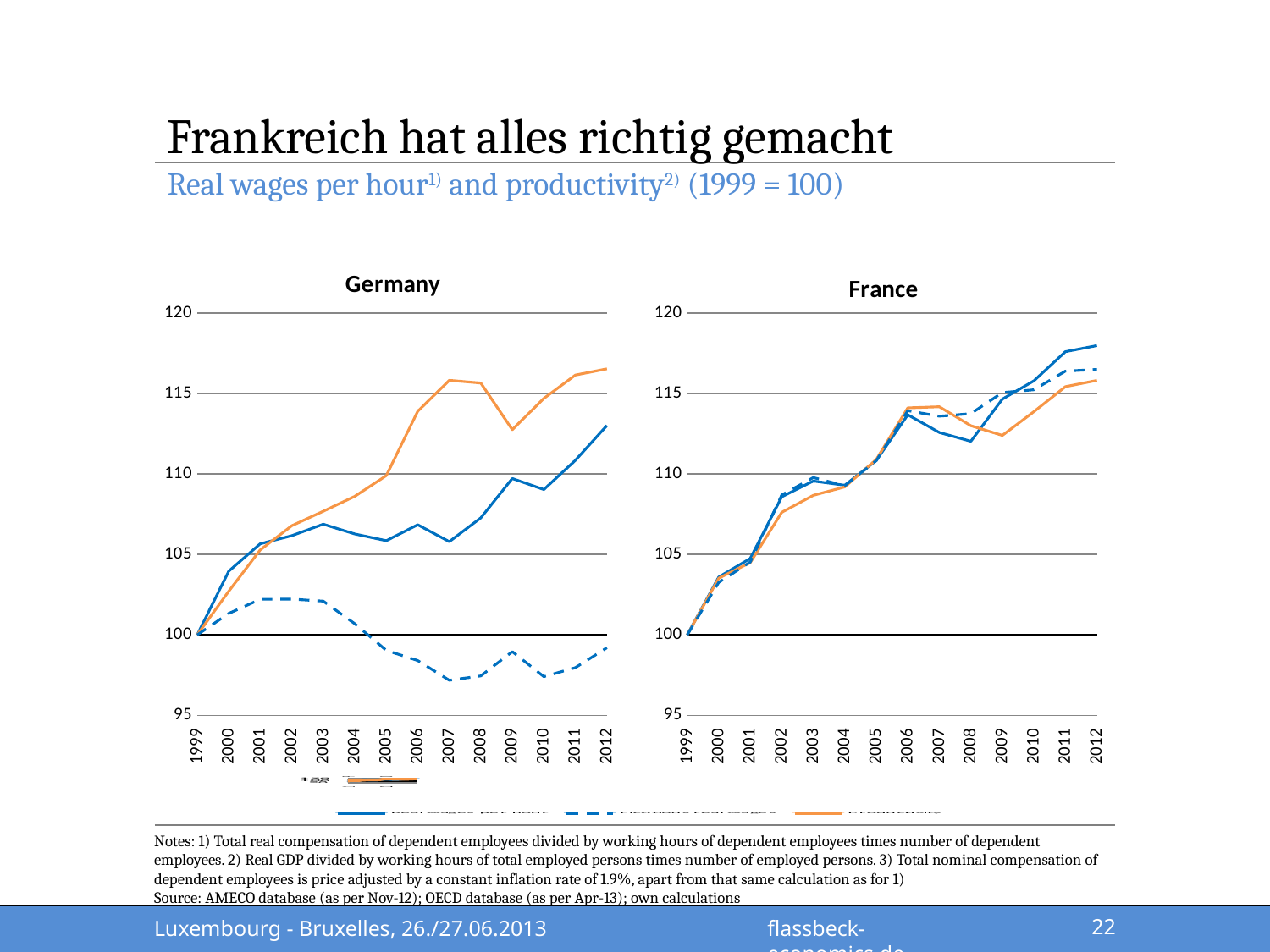
In the Germany chart, is the value of the dashed blue line in 2007 greater or less than 100? less In the France chart, is the value of the solid blue line in 2012 greater or less than 115? greater What are the titles of the two charts on the slide? Germany and France What type of chart is used for the Germany panel? line chart In the France chart, is the value of the orange line in 2002 greater or less than 110? less In the Germany chart, which is higher in 2012, the orange line or the solid blue line? the orange line In the France chart, in which year does the solid blue line reach its highest value? 2012 How many series does the legend below the charts list? 3 How many years are shown on the x axis of the France chart? 14 In the Germany chart, does the orange line rise or fall overall from 1999 to 2012? rise In the Germany chart, what is the value of all lines in 1999? 100